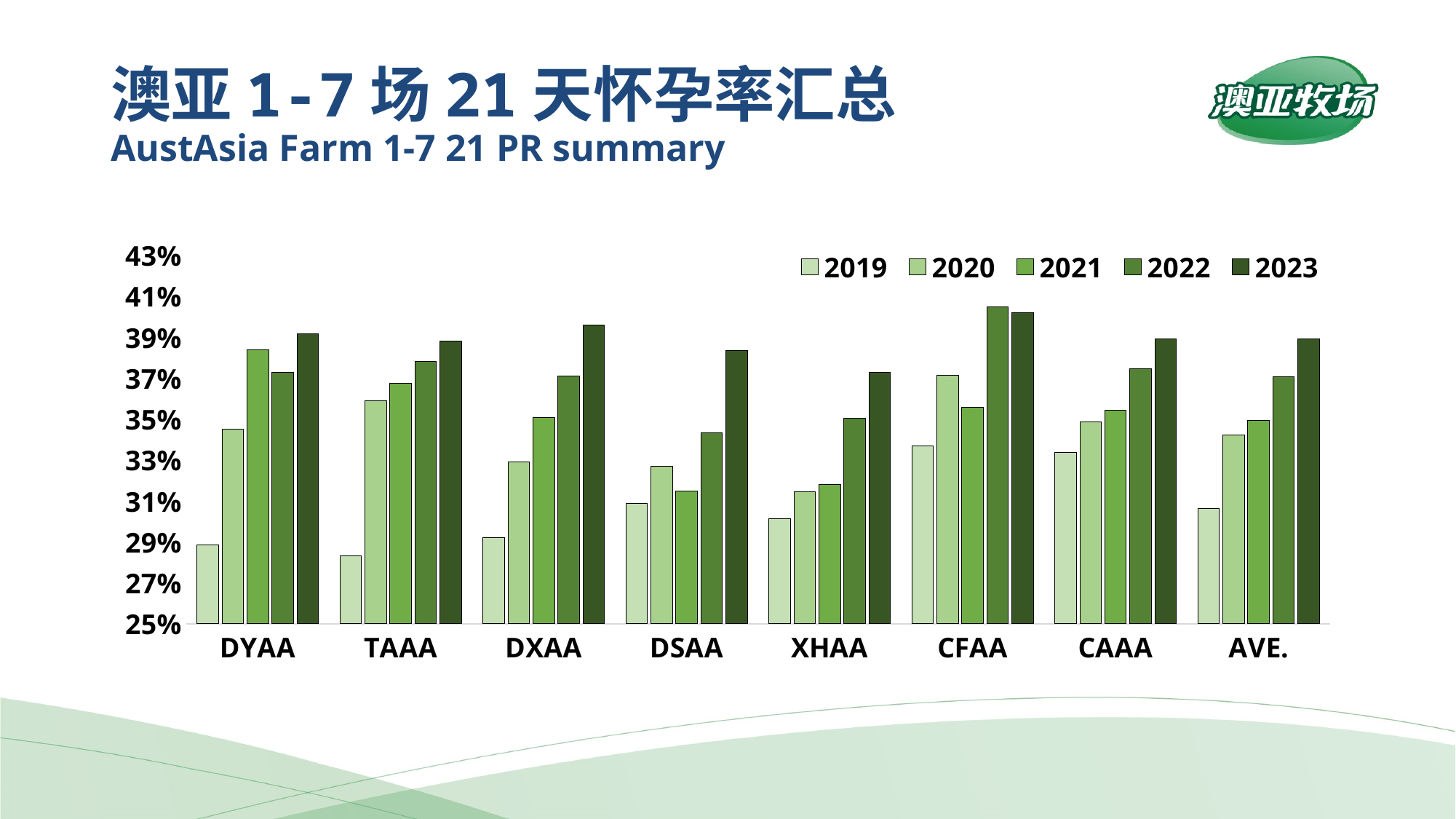
Is the 2022 value for CFAA greater or less than 39%? greater Is the 2019 value for DYAA greater or less than 31%? less Which farm has the highest 2022 value? CFAA For CFAA, which is larger: the 2020 value or the 2021 value? 2020 Is the 2023 value for DXAA greater or less than 37%? greater What kind of chart is shown on the slide? bar chart How many categories are shown along the x axis? 8 Do the AVE. values rise or fall from 2019 to 2023? rise How many series does the legend list? 5 For DSAA, which is larger: the 2022 value or the 2023 value? 2023 Which farm has the lowest 2022 value? DSAA